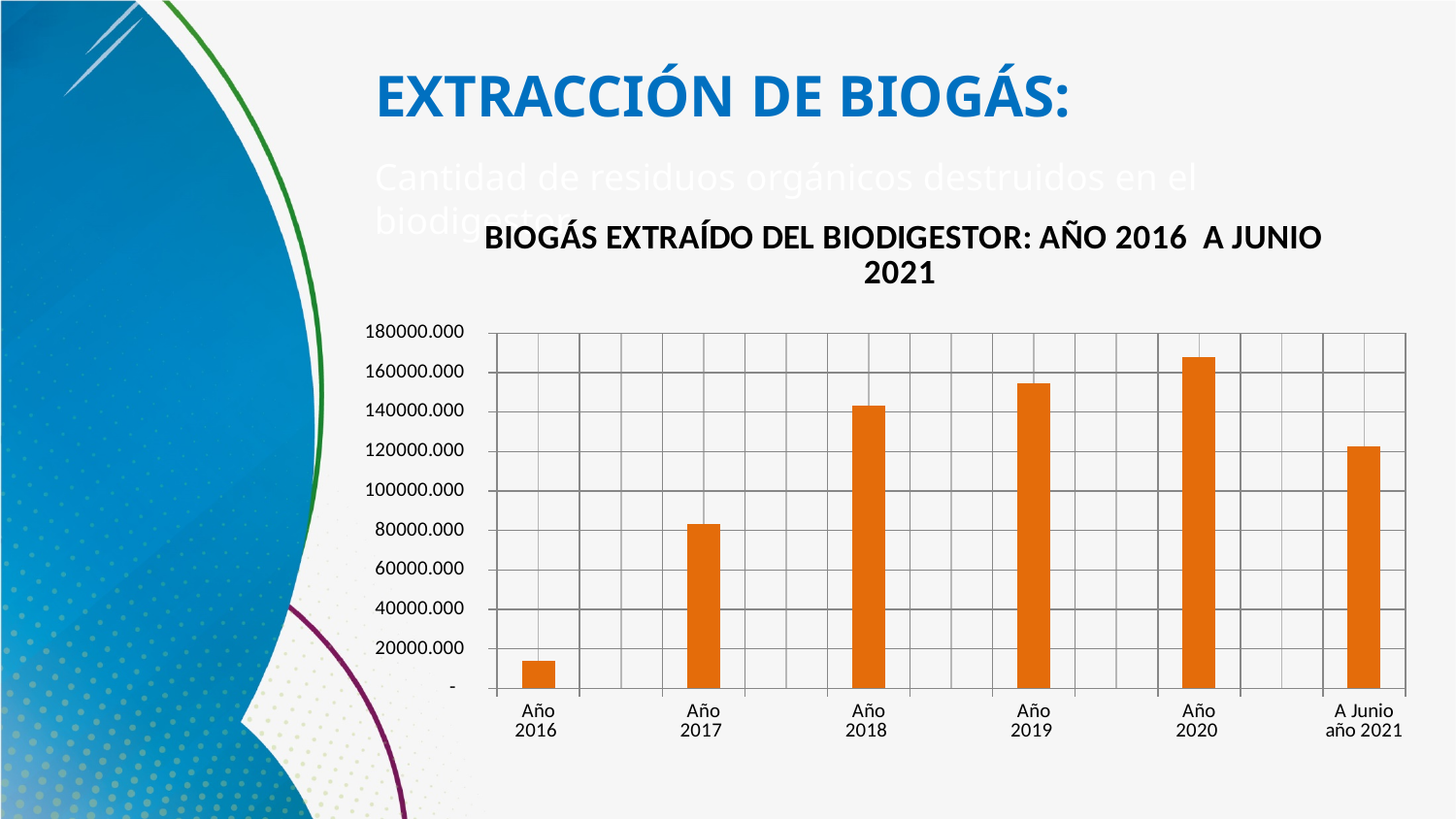
Which is larger, the value for Año 2019 or the value for Año 2018? Año 2019 What kind of chart is shown on the slide? Bar chart Is the value for A Junio año 2021 greater or less than 140000.000? less Is the value for Año 2019 greater or less than 140000.000? greater Which category has the lowest value in the chart? Año 2016 Do the values rise or fall from Año 2016 to Año 2020? rise How many bars (categories) are plotted in the chart? 6 Is the value for Año 2020 greater or less than 160000.000? greater Which category has the highest value in the chart? Año 2020 What is the title of the chart? BIOGÁS EXTRAÍDO DEL BIODIGESTOR: AÑO 2016 A JUNIO 2021